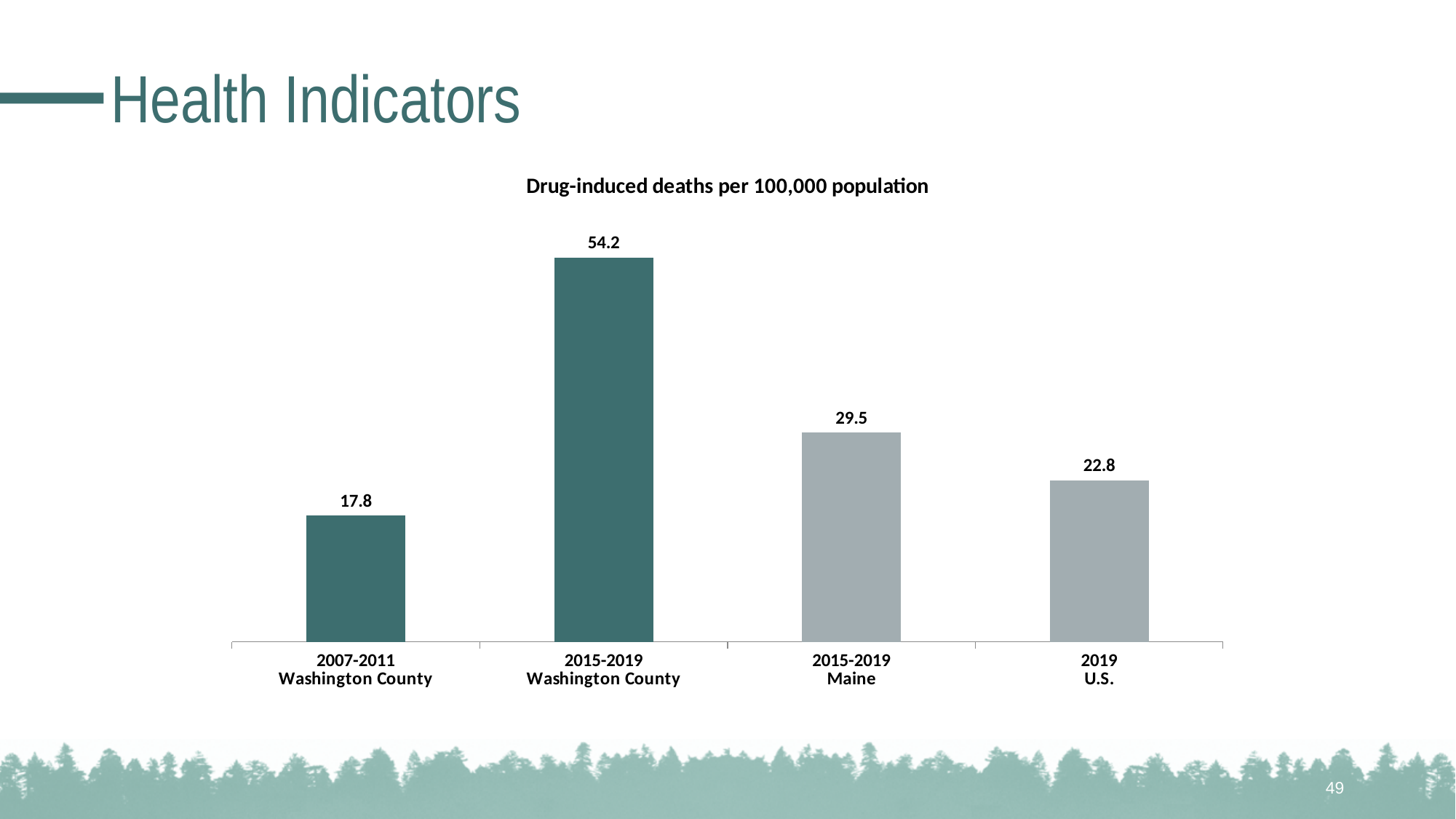
What is the difference between the 2015-2019 Maine value and the 2019 U.S. value? 6.7 How many categories are shown on the chart? 4 Which category has the lowest value? 2007-2011 Washington County What is the value for 2019 U.S.? 22.8 What is the value for 2007-2011 Washington County? 17.8 What kind of chart is shown on the slide? Bar chart Which is larger, the value for 2015-2019 Maine or the value for 2019 U.S.? 2015-2019 Maine What is the value for 2015-2019 Maine? 29.5 Which category has the highest value? 2015-2019 Washington County What is the difference between the 2015-2019 Washington County value and the 2007-2011 Washington County value? 36.4 What is the title of the chart? Drug-induced deaths per 100,000 population What is the value for 2015-2019 Washington County? 54.2